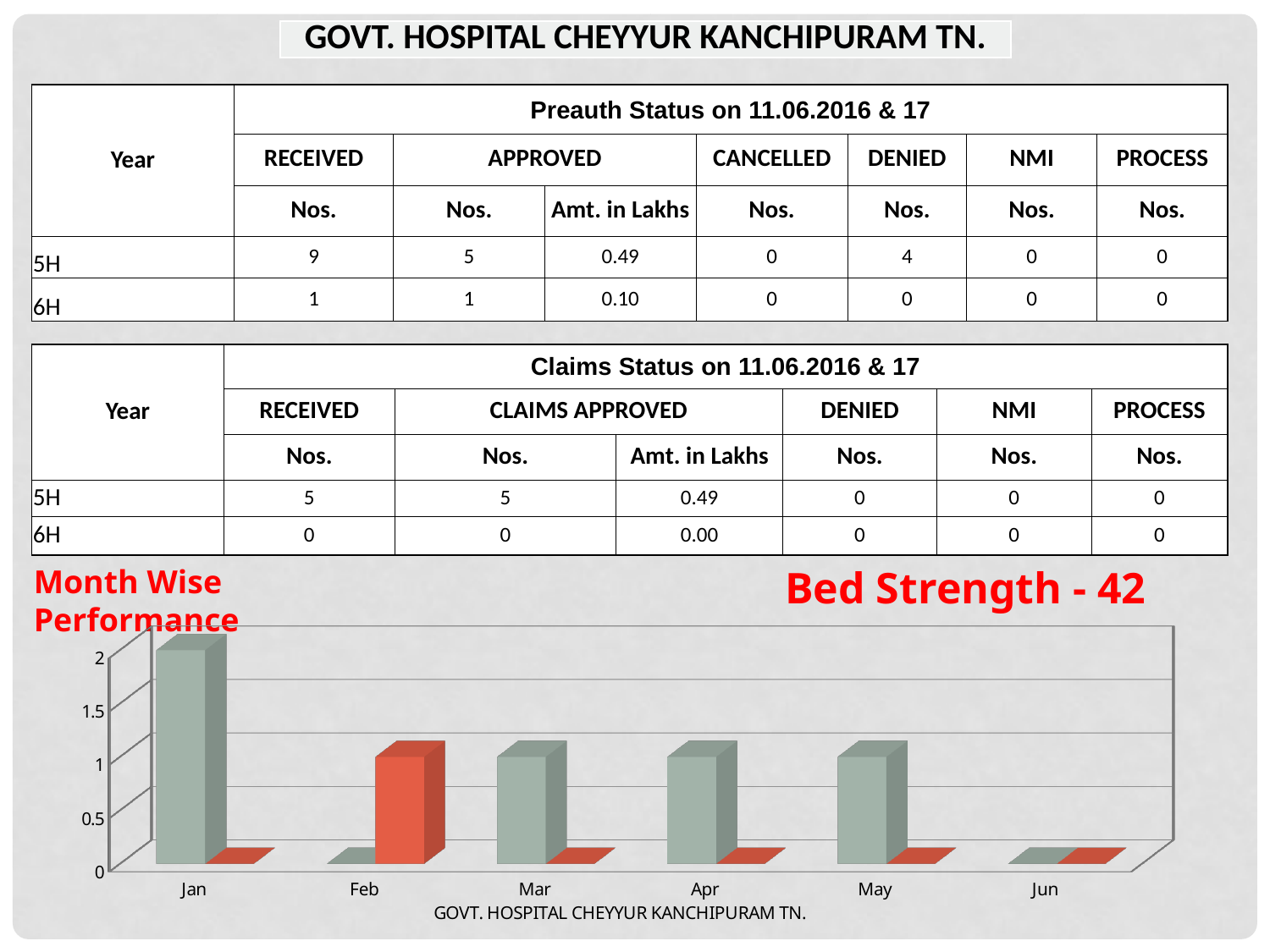
In the Month Wise Performance chart, which is larger: the grey bar for Jan or the grey bar for May? Jan In the Month Wise Performance chart, what is the value of the grey bar for Mar? 1 Which is the only month with a visible red bar in the Month Wise Performance chart? Feb In the Month Wise Performance chart, what is the value of the red bar for Feb? 1 What text appears as the axis title below the months in the Month Wise Performance chart? GOVT. HOSPITAL CHEYYUR KANCHIPURAM TN. Which month has the tallest bar in the Month Wise Performance chart? Jan How many months are shown on the x axis of the Month Wise Performance chart? 6 In the Month Wise Performance chart, is the grey bar for Jan greater or less than 1.5? greater In the Month Wise Performance chart, what is the difference between the grey bar for Jan and the grey bar for Apr? 1 Which month shows no visible bar for either series in the Month Wise Performance chart? Jun In the Month Wise Performance chart, what is the value of the grey bar for Jan? 2 What kind of chart is shown at the bottom of the slide? bar chart